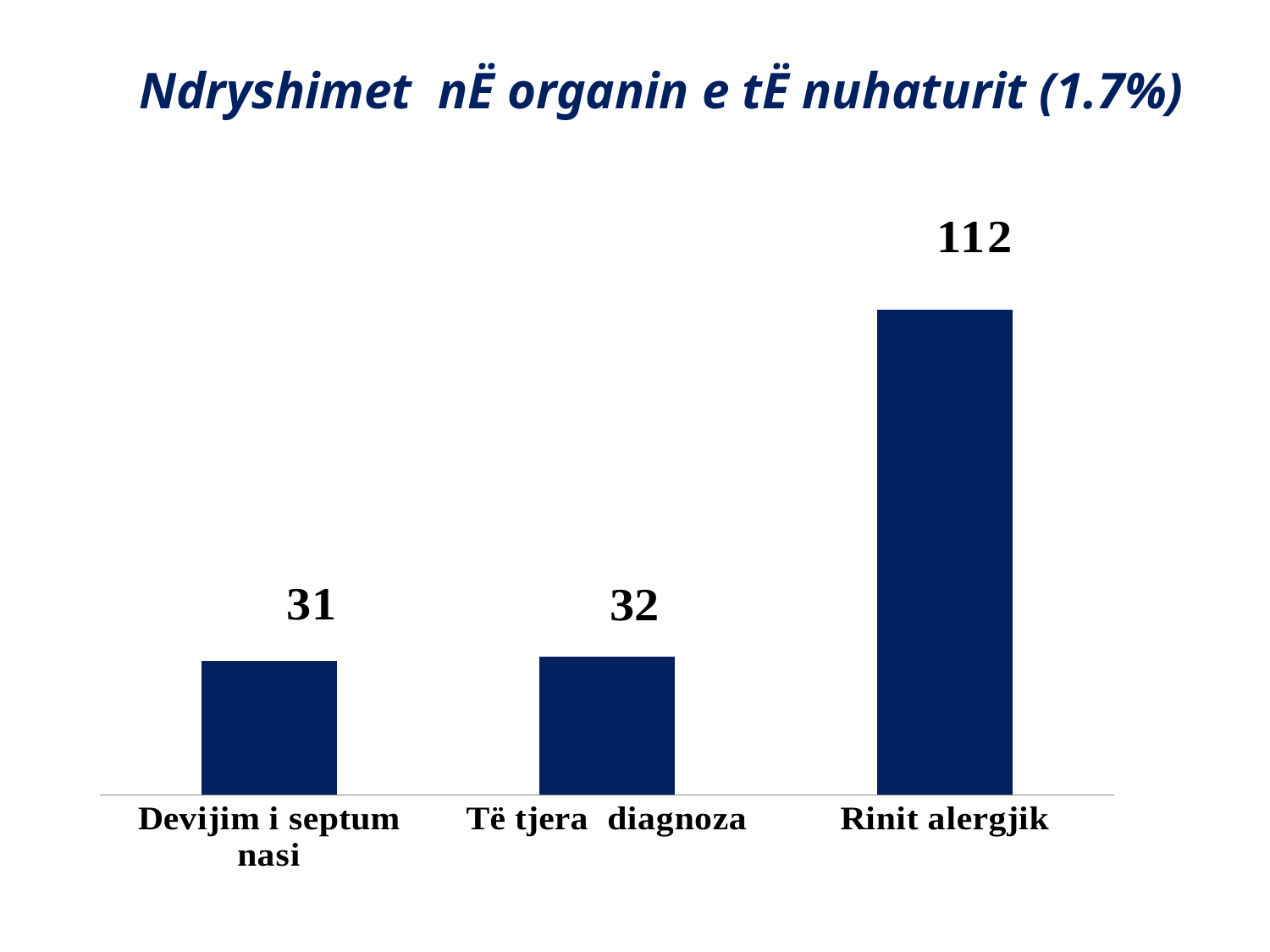
Which is larger, the value for Rinit alergjik or the value for Devijim i septum nasi? Rinit alergjik What is the value for Të tjera diagnoza? 32 How many categories are shown in the chart? 3 What is the title of the slide? Ndryshimet nË organin e tË nuhaturit (1.7%) What is the difference between the values for Të tjera diagnoza and Devijim i septum nasi? 1 Which category has the highest value? Rinit alergjik What is the difference between the values for Rinit alergjik and Të tjera diagnoza? 80 What is the value for Devijim i septum nasi? 31 Which category has the lowest value? Devijim i septum nasi What is the value for Rinit alergjik? 112 What kind of chart is shown on the slide? Bar chart What colour are the bars in the chart? Dark blue